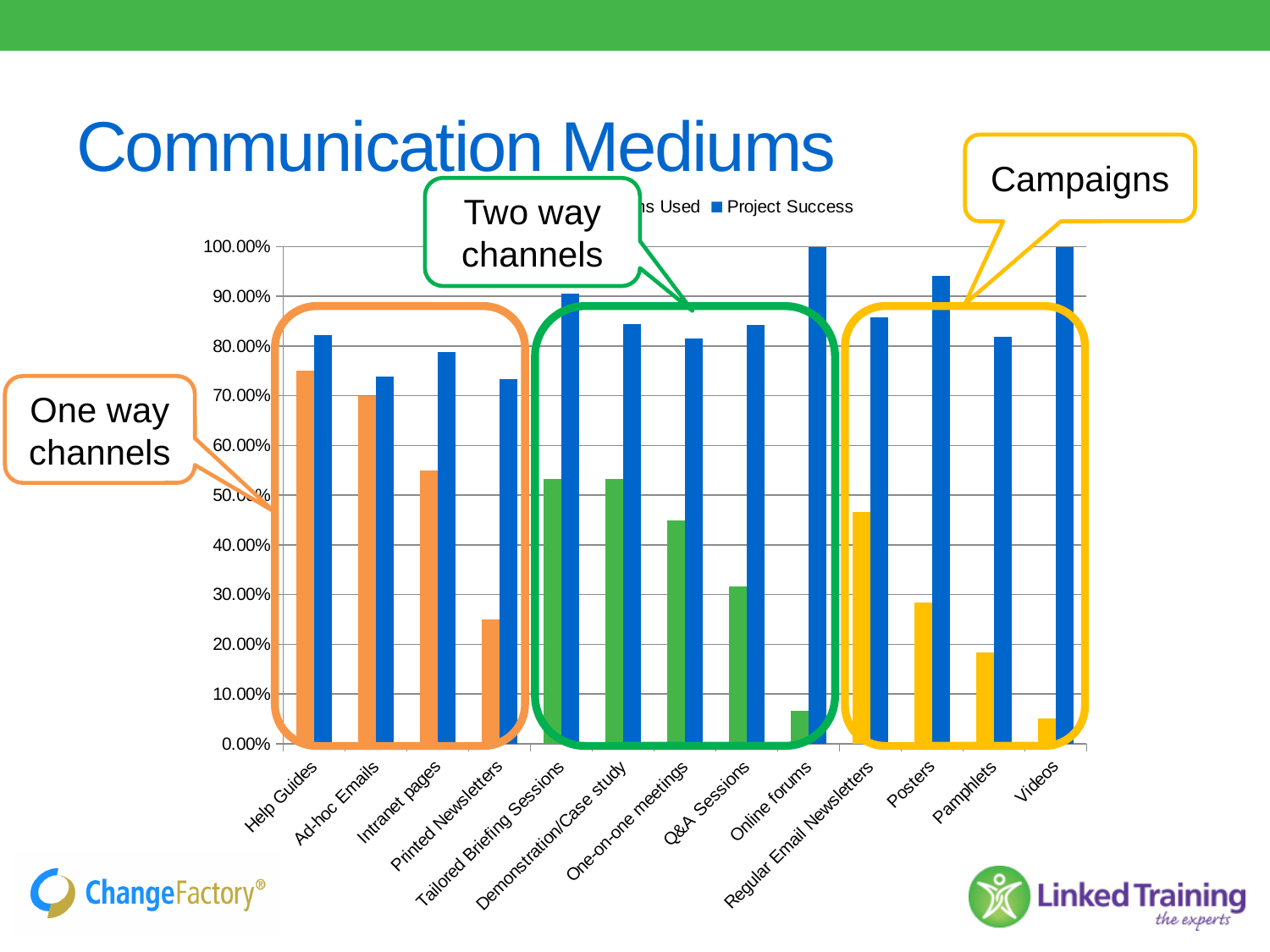
Is the Project Success value for Posters greater or less than 90.00%? greater Which has the larger first-series (orange) value: Intranet pages or Printed Newsletters? Intranet pages Which category has the highest value for the first (non-blue) series? Help Guides How many categories are shown along the x axis of the chart? 13 Which three groups of channels are labelled by the callouts over the chart? One way channels, Two way channels, Campaigns How many series does the chart's legend list? 2 Is the first-series (green) value for Online forums greater or less than 10.00%? less Which has the larger Project Success value: Posters or Pamphlets? Posters Is the first-series (orange) value for Intranet pages greater or less than 50.00%? greater What kind of chart is shown on the slide? bar chart